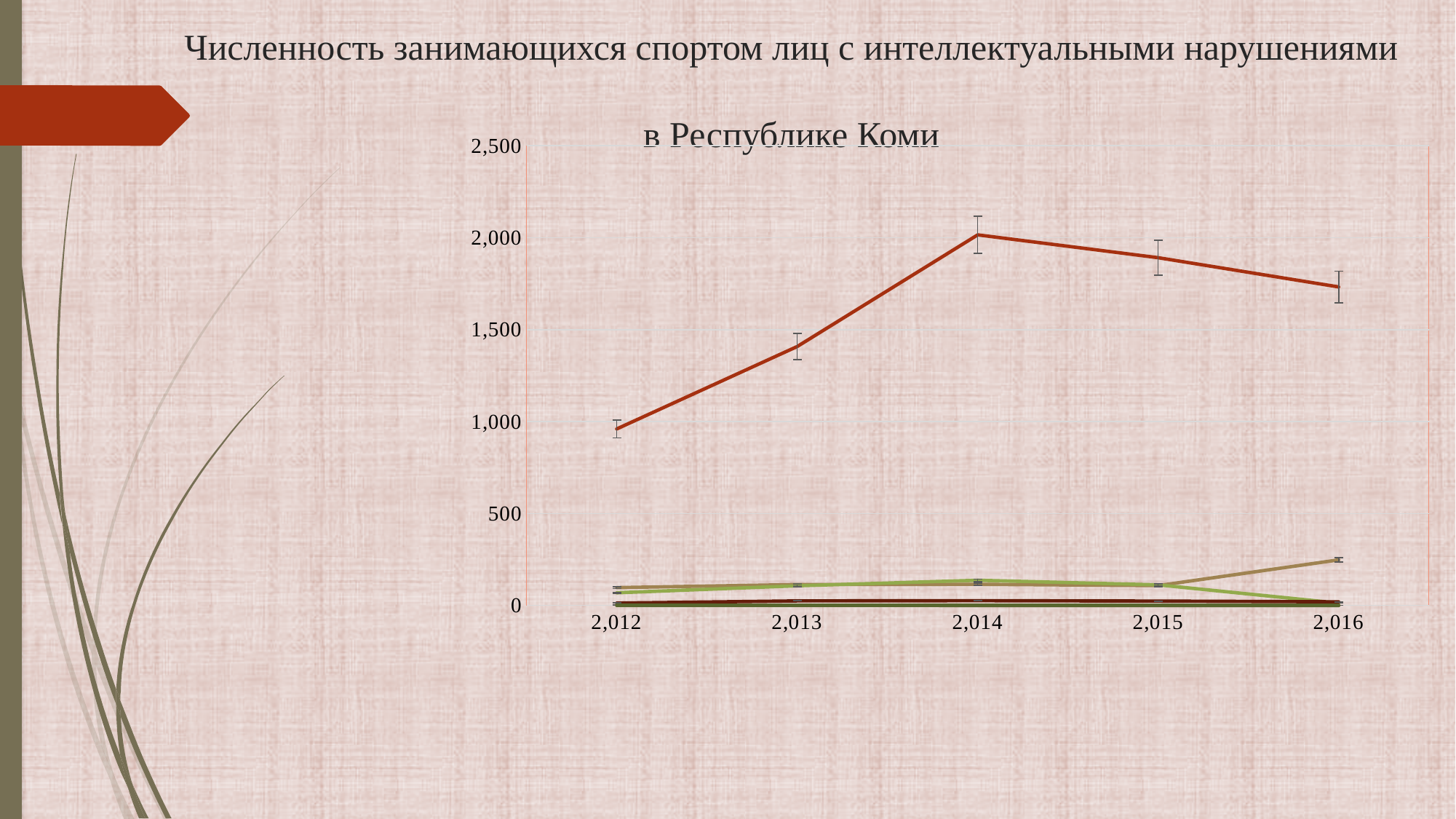
Is the value of the red line for 2,014 greater or less than 1,500? greater What kind of chart is shown on the slide? line chart Is the value of the tan line for 2,016 greater or less than 500? less How many years are shown along the x axis of the chart? 5 Does the red line rise or fall between 2,014 and 2,016? fall Is the value of the red line for 2,012 greater or less than 1,500? less Which is larger for the red line: the value for 2,014 or the value for 2,012? 2,014 In which year does the red (top) line reach its highest value? 2,014 What is the highest value labelled on the y axis of the chart? 2,500 In which year does the red (top) line have its lowest value? 2,012